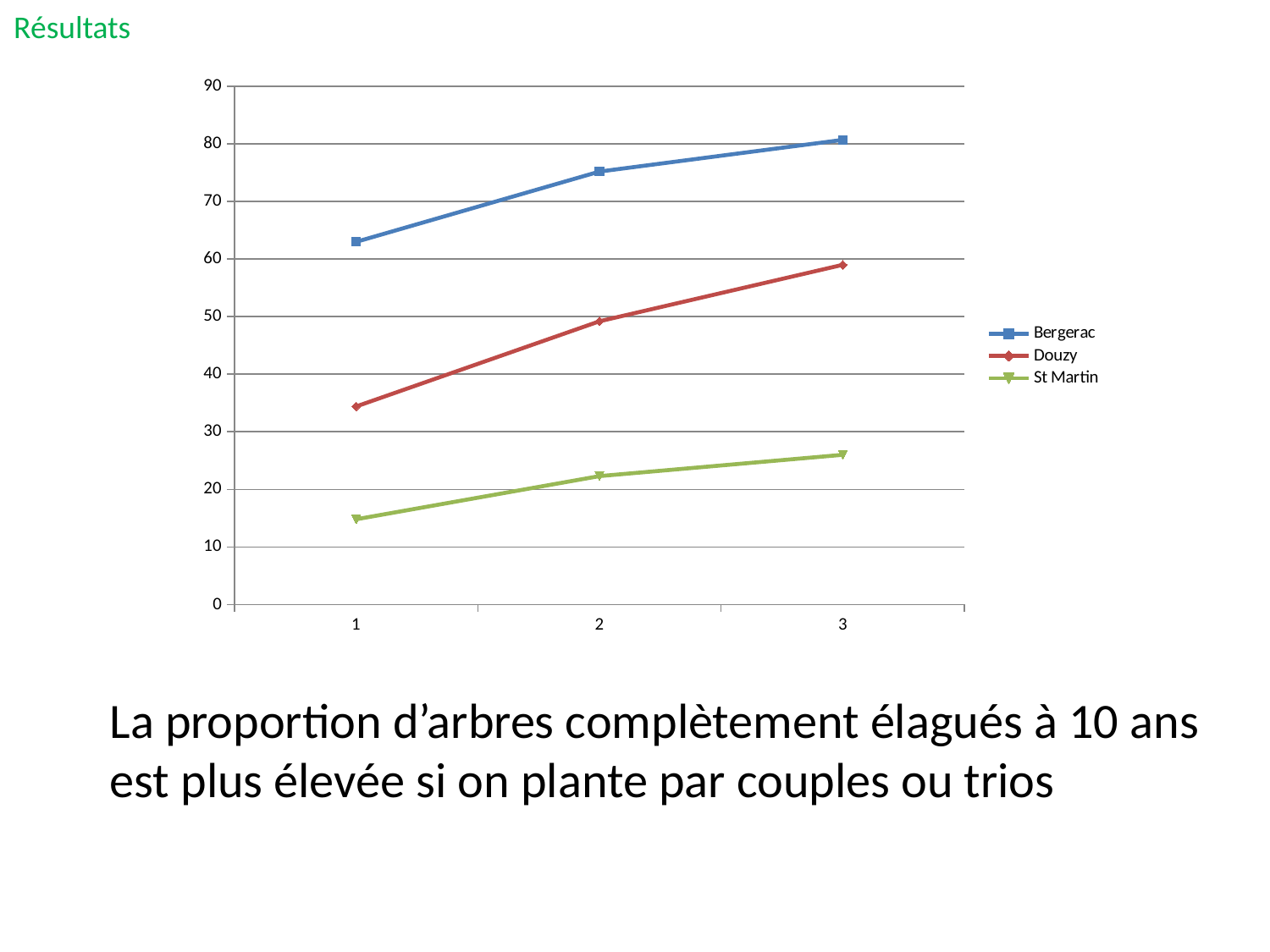
Which series has the highest value at x = 3? Bergerac How many points are plotted along the x axis for each series? 3 Is the value for St Martin at x = 3 greater or less than 30? less Which series has the lowest value at x = 1? St Martin What kind of chart is shown on the slide? line chart Do the values for Douzy rise or fall from x = 1 to x = 3? rise Which is larger: Douzy at x = 3 or Bergerac at x = 1? Bergerac at x = 1 Which series is drawn in red? Douzy How many series does the legend list? 3 Is the value for Bergerac at x = 1 greater or less than 60? greater